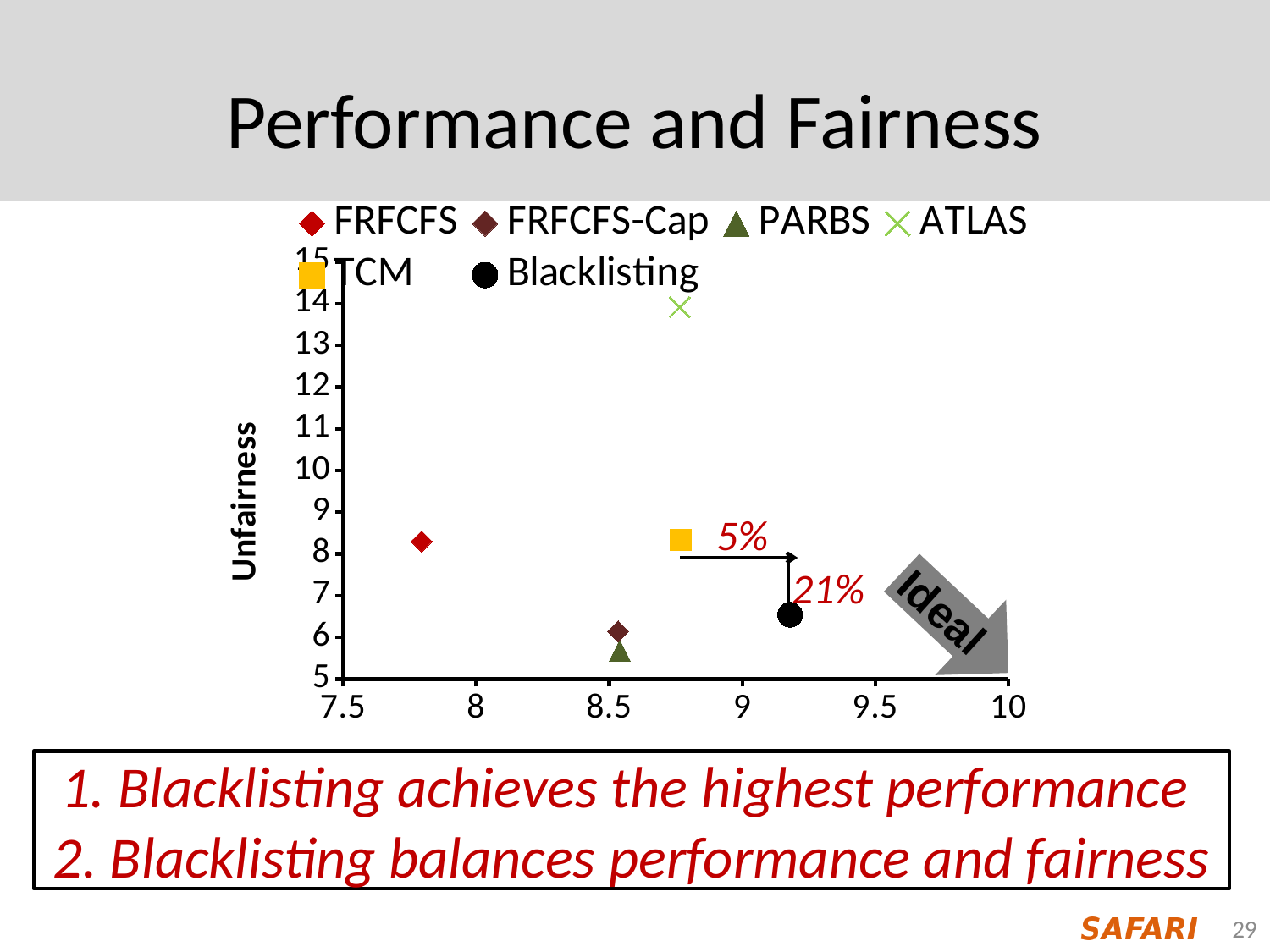
How many data points are plotted on the chart? 6 Is the Unfairness value for ATLAS greater or less than 13? greater Which series has the lowest value on the horizontal axis? FRFCFS Which has the higher horizontal-axis value, FRFCFS or Blacklisting? Blacklisting Which has the higher Unfairness value, ATLAS or TCM? ATLAS Which series has the highest Unfairness value? ATLAS What is the label on the vertical axis of the chart? Unfairness How many series does the legend list? 6 Is the horizontal-axis value for Blacklisting greater or less than 9? greater What kind of chart is shown on the slide? scatter chart Is the Unfairness value for Blacklisting greater or less than 7? less Which series has the highest value on the horizontal axis? Blacklisting